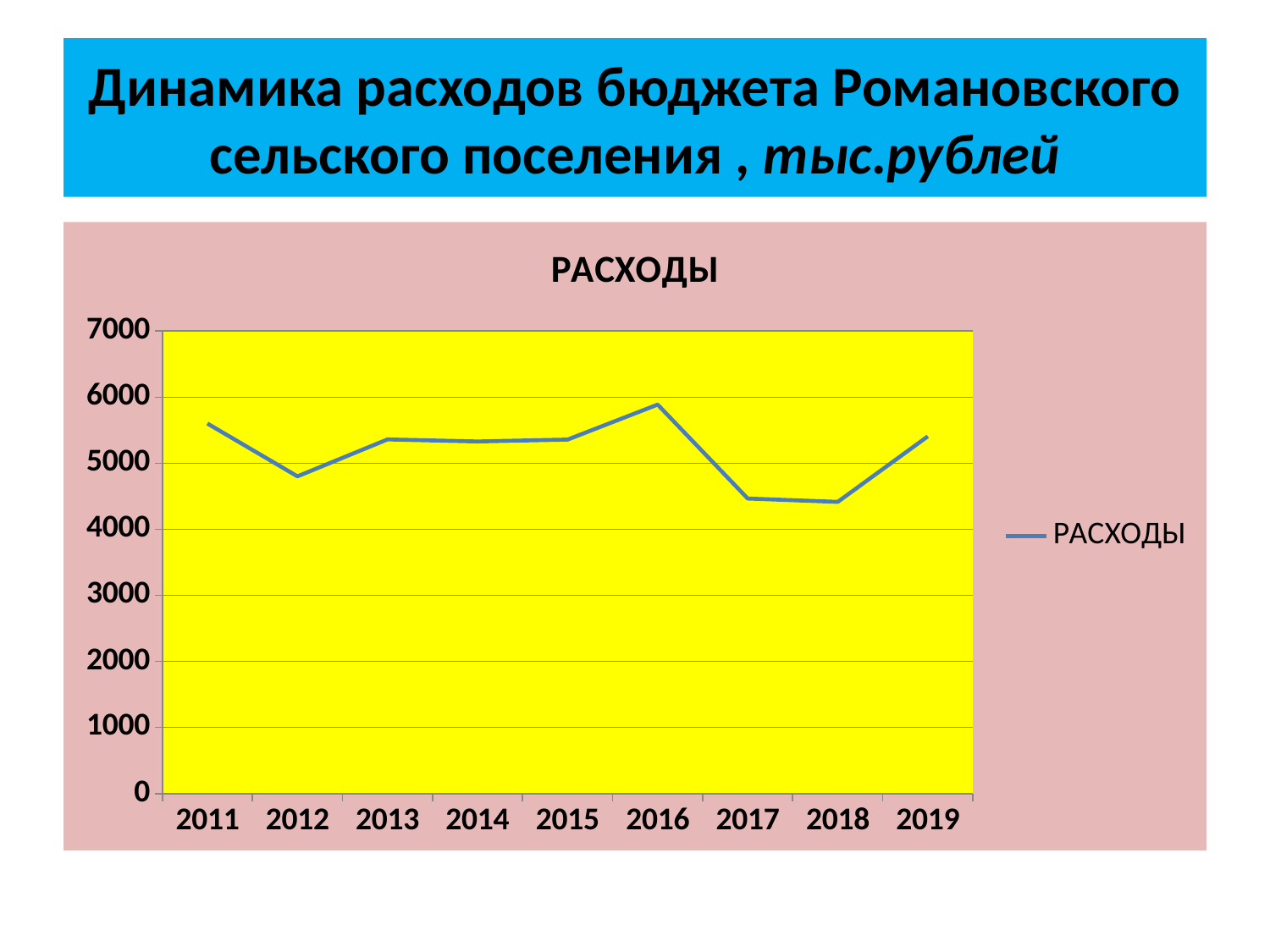
Is the value for 2011 greater or less than 5000? greater Is the value for 2012 greater or less than 5000? less How many years are plotted on the x axis of the chart? 9 Is the value for 2016 greater or less than 5000? greater Which year has the larger value, 2011 or 2017? 2011 Which year has the larger value, 2016 or 2012? 2016 What kind of chart is shown on the slide? line chart What is the title shown above the plot area of the chart? РАСХОДЫ In which year is the value of РАСХОДЫ highest? 2016 Do the values rise or fall from 2016 to 2018? fall How many series does the chart legend list? 1